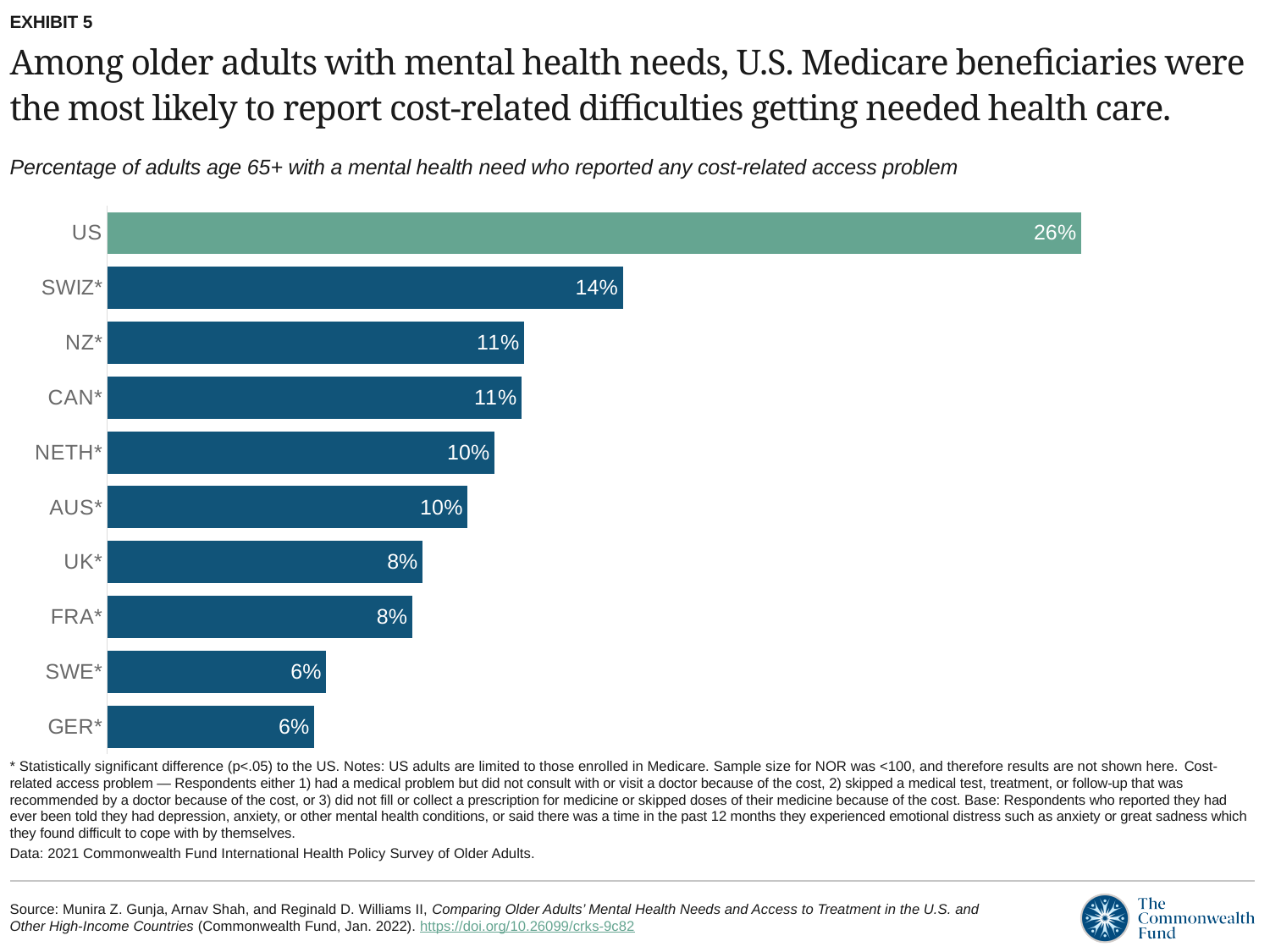
How many countries are shown in the chart? 10 What is the difference between the values for US and SWIZ*? 12% Which country has the highest value? US What is the value for GER*? 6% Which has a larger value, FRA* or AUS*? AUS* Which bar is shown in a different colour from the others? US Which has a larger value, SWIZ* or NZ*? SWIZ* What is the difference between the values for CAN* and UK*? 3% What is the value for SWIZ*? 14% What is the value for US? 26% What is the value for NETH*? 10% What kind of chart is shown on the slide? Bar chart